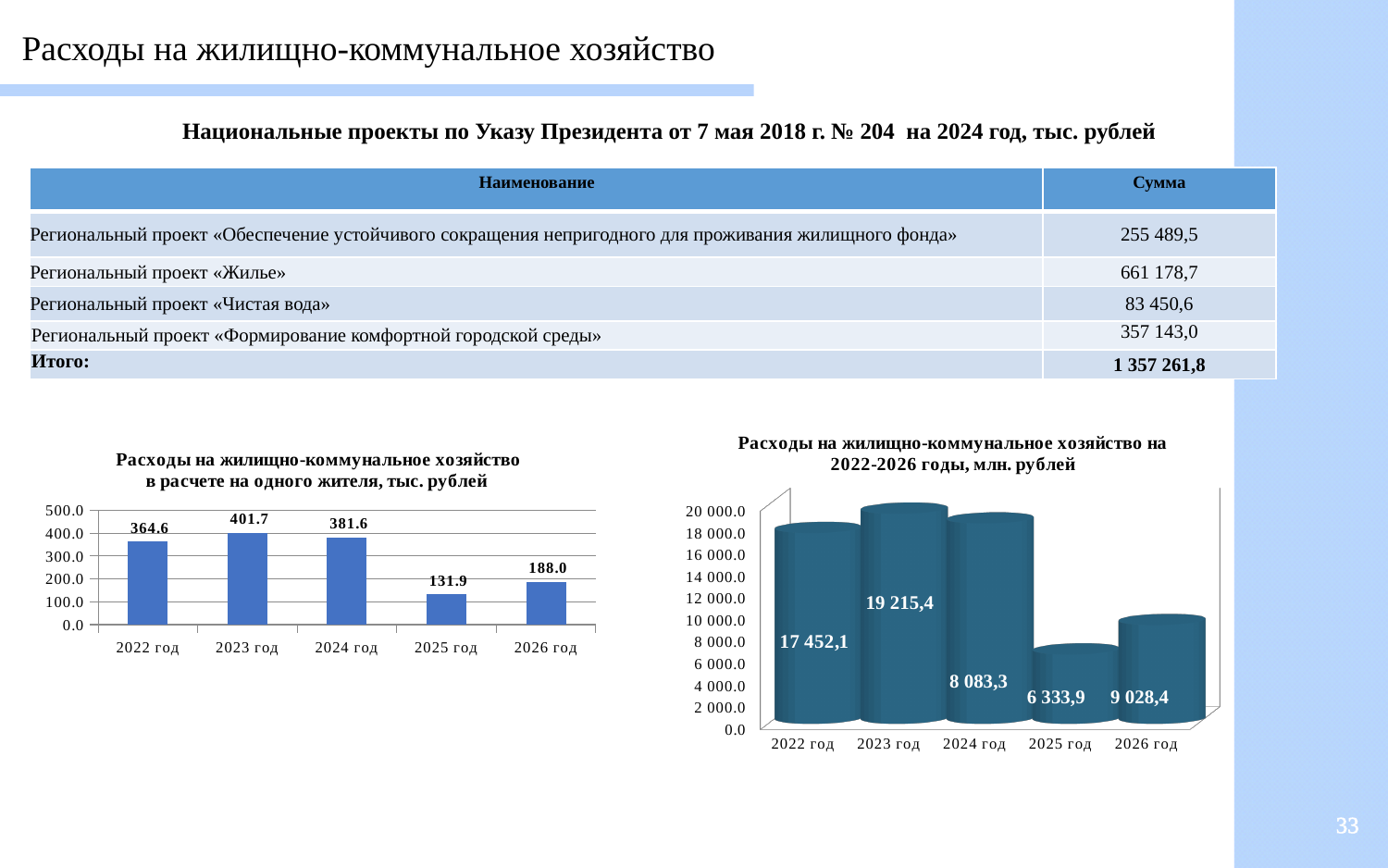
In the left chart (per-resident expenses, тыс. рублей), how many years are shown on the x axis? 5 In the left chart (per-resident expenses, тыс. рублей), what is the difference between the values for 2026 год and 2025 год? 56.1 In the right chart (expenses for 2022-2026, млн. рублей), what is the value for 2025 год? 6 333,9 In the left chart (per-resident expenses, тыс. рублей), which year has the highest value? 2023 год In the left chart (per-resident expenses, тыс. рублей), what is the value for 2023 год? 401.7 In the right chart (expenses for 2022-2026, млн. рублей), which is larger: the value for 2024 год or 2026 год? 2024 год In the left chart (per-resident expenses, тыс. рублей), which year has the lowest value? 2025 год In the left chart (per-resident expenses, тыс. рублей), is the value for 2024 год greater or less than 300.0? greater In the right chart (expenses for 2022-2026, млн. рублей), which year has the highest value? 2023 год In the right chart (expenses for 2022-2026, млн. рублей), what is the difference between the values for 2023 год and 2022 год? 1 763,3 What type of chart is the right chart (expenses for 2022-2026, млн. рублей)? bar chart In the right chart (expenses for 2022-2026, млн. рублей), what is the value for 2022 год? 17 452,1